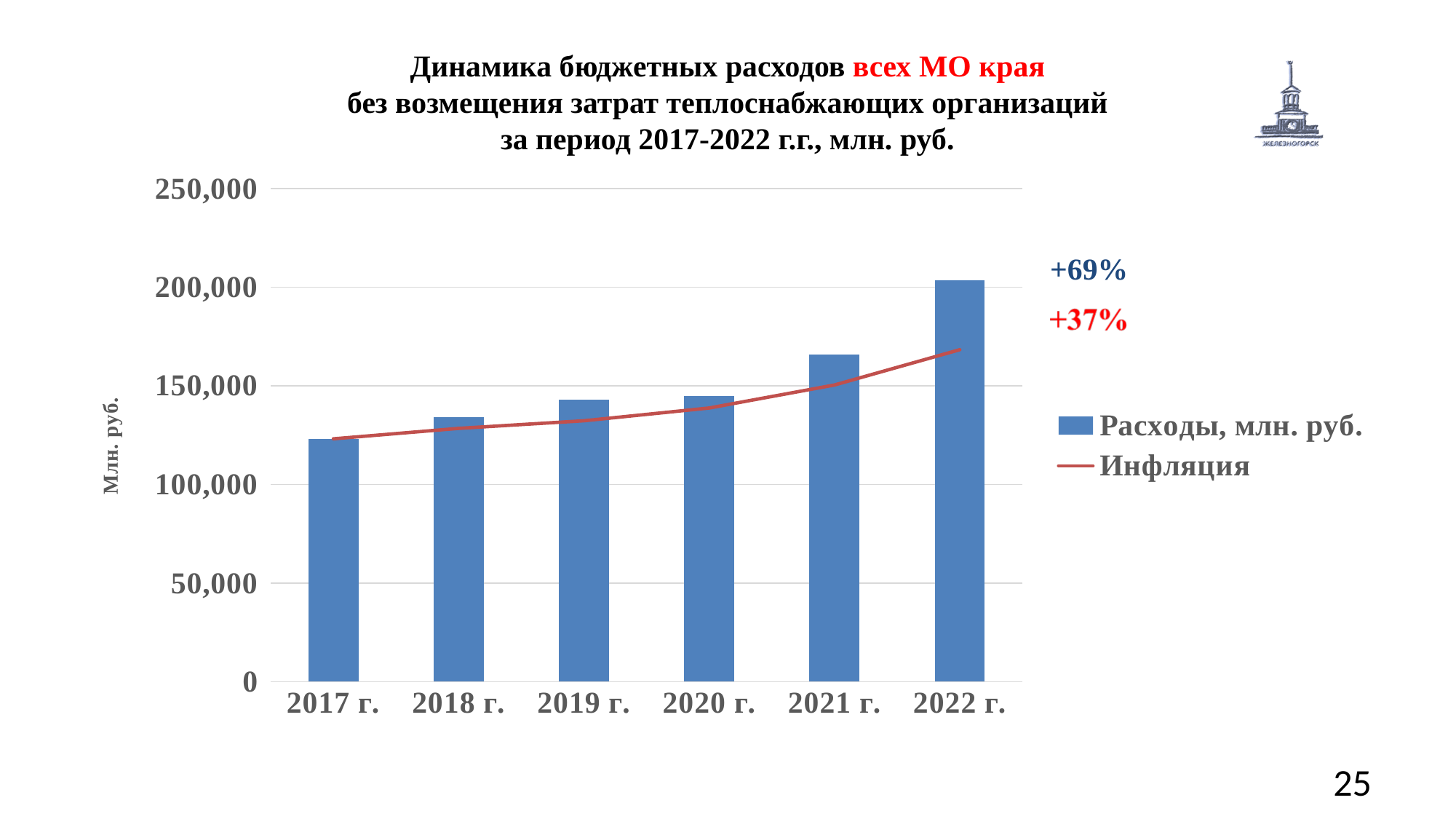
Which year has the lowest value for Расходы, млн. руб.? 2017 г. How many series does the chart legend list? 2 What kind of chart is shown on the slide? Bar chart with a line Do the values for Расходы, млн. руб. rise or fall from 2017 г. to 2022 г.? Rise What percentage growth is annotated in blue next to the chart? +69% Is the value for Расходы, млн. руб. in 2022 г. greater or less than 200,000? greater Is the value for Расходы, млн. руб. in 2021 г. greater or less than 150,000? greater How many years are shown on the x axis of the chart? 6 What is the name of the series drawn as a red line in the chart? Инфляция Is the value for Расходы, млн. руб. in 2017 г. greater or less than 150,000? less Which is larger, the value for Расходы, млн. руб. in 2021 г. or in 2020 г.? 2021 г. Which year has the highest value for Расходы, млн. руб.? 2022 г.